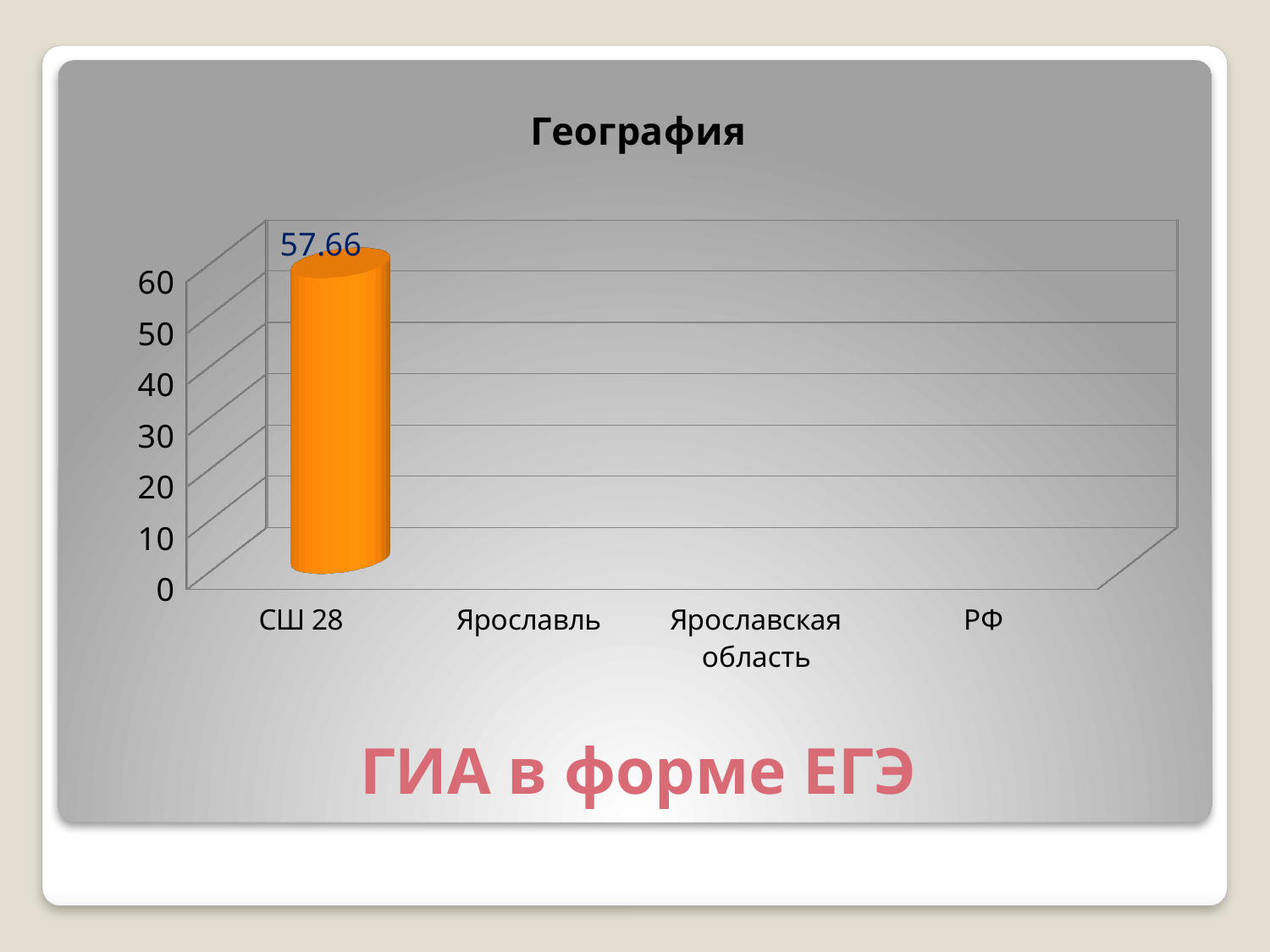
What is the title of the chart? География What is the highest tick value shown on the vertical axis of the География chart? 60 What type of chart is shown on the slide? bar chart How many categories are listed along the x axis of the География chart? 4 Is the value for СШ 28 greater or less than 50? greater What is the value shown for СШ 28 in the География chart? 57.66 Is the value for СШ 28 greater or less than 60? less Which category has the highest plotted value in the География chart? СШ 28 What colour is the bar for СШ 28? orange How many bars are actually plotted in the География chart? 1